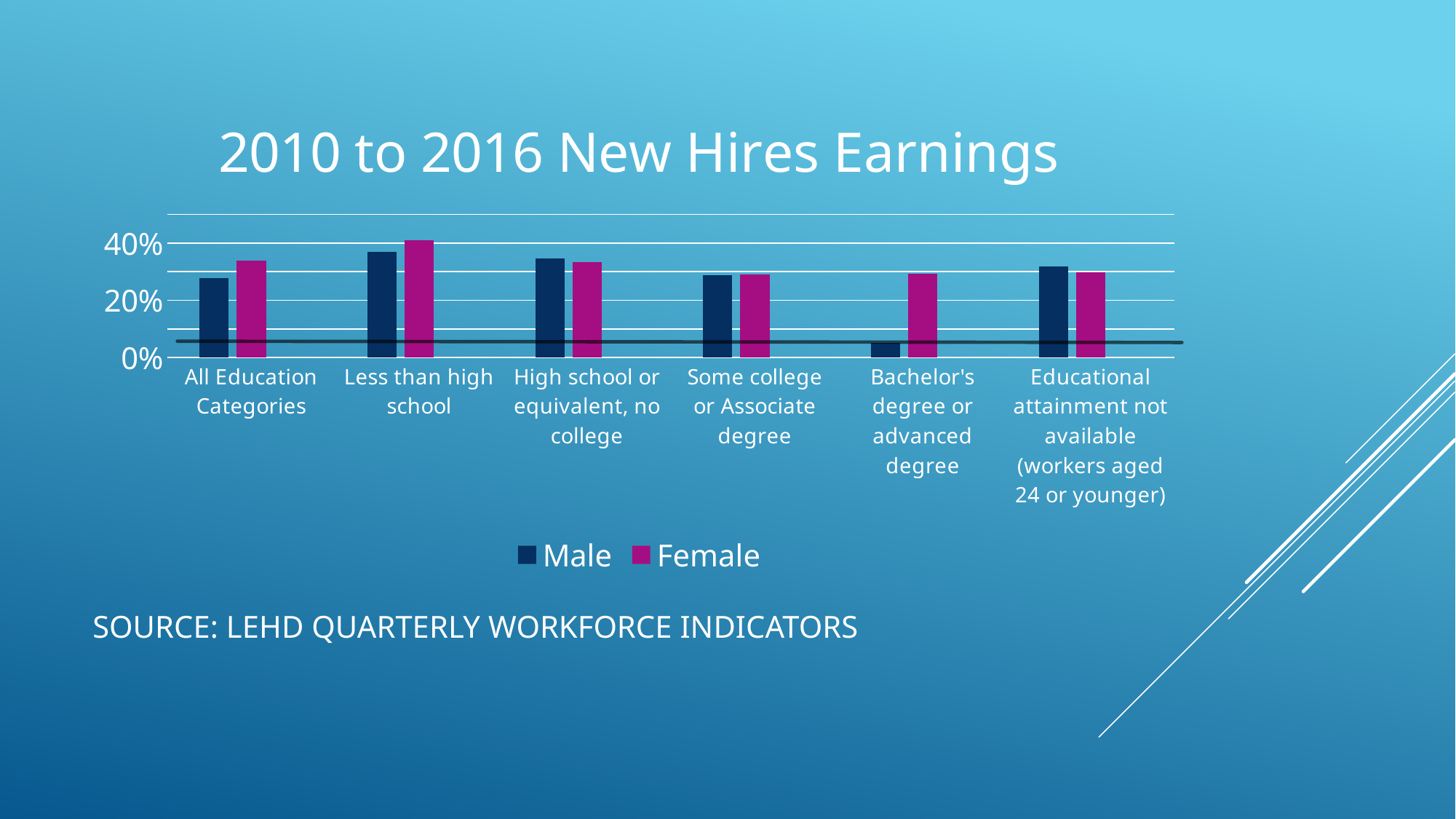
Which colour represents the Female series in the legend? Magenta How many series does the legend list? 2 Is the Female value for Some college or Associate degree greater or less than 40%? less What kind of chart is shown on the slide? Bar chart Which category has the lowest Male value? Bachelor's degree or advanced degree How many education categories are shown on the x axis? 6 Which category has the highest Female value? Less than high school What is the title of the chart? 2010 to 2016 New Hires Earnings Is the Male value for All Education Categories greater or less than 20%? greater Is the Male value for Bachelor's degree or advanced degree greater or less than 20%? less For All Education Categories, which is larger, the Male value or the Female value? Female For Bachelor's degree or advanced degree, which is larger, the Male value or the Female value? Female